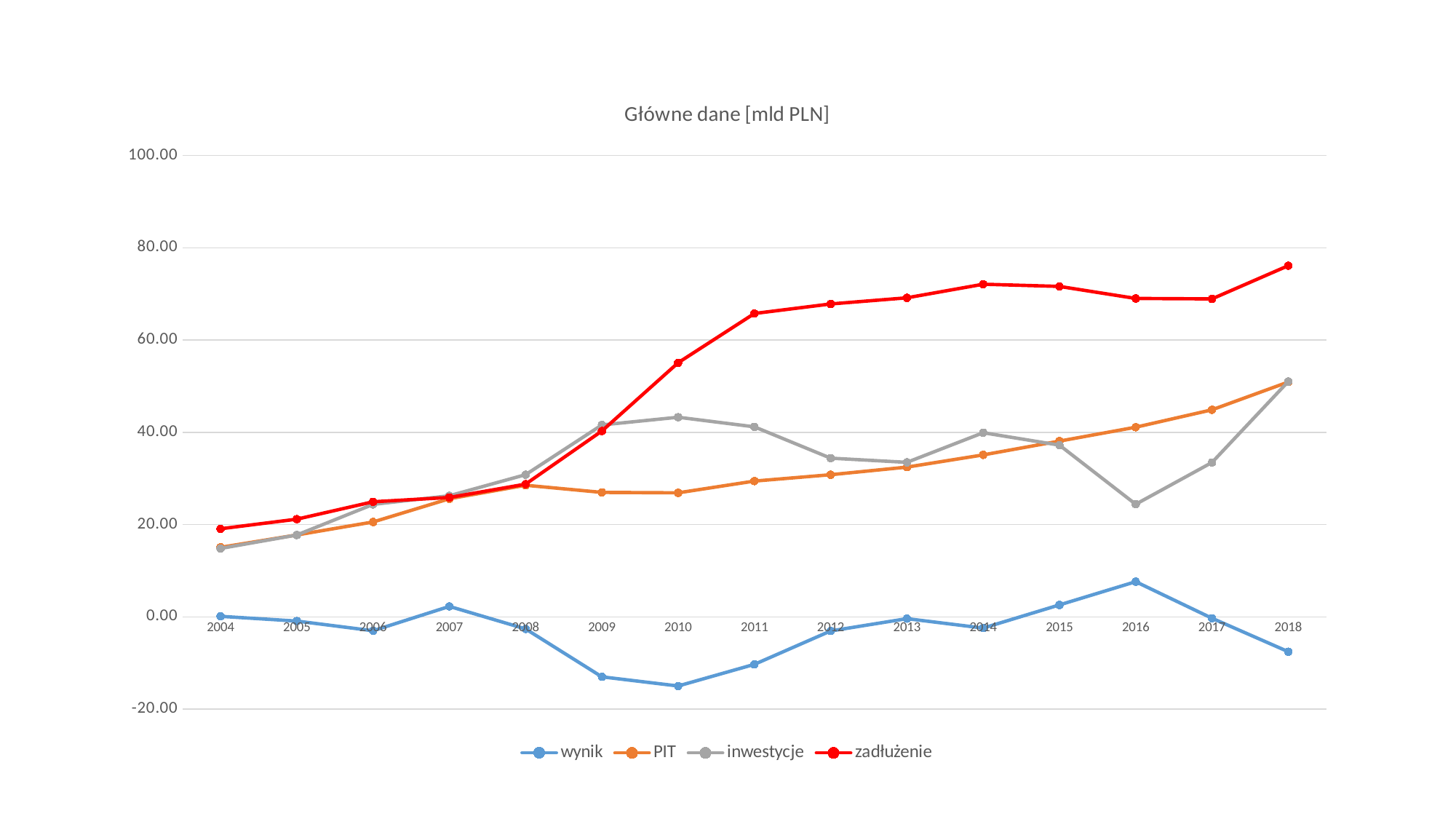
Is the value for PIT in 2004 greater or less than 20.00? less Which colour is used for the zadłużenie series? red Does the zadłużenie series rise or fall from 2004 to 2018? rise In which year does the wynik series reach its highest value? 2016 What kind of chart is shown on the slide? line chart What is the title of the chart? Główne dane [mld PLN] Is the value for wynik in 2010 greater or less than 0.00? less Which series has the highest value in 2018? zadłużenie In 2016, which is larger: PIT or inwestycje? PIT How many years are plotted along the x axis? 15 How many series does the legend list? 4 Is the value for zadłużenie in 2018 greater or less than 60.00? greater